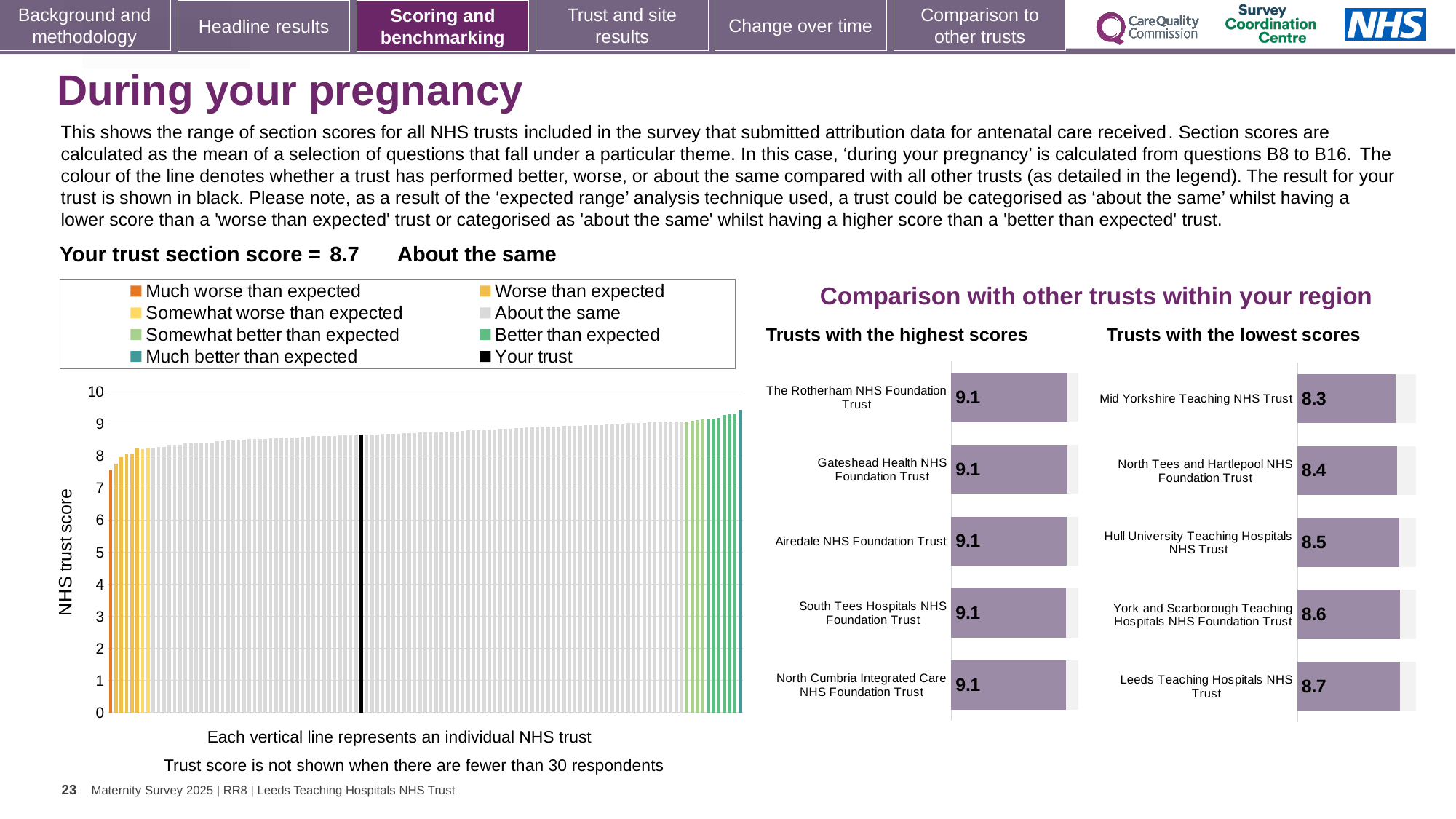
How many trusts are shown in the 'Trusts with the highest scores' chart? 5 In the 'Trusts with the lowest scores' chart, which trust has the highest score? Leeds Teaching Hospitals NHS Trust In the 'Trusts with the lowest scores' chart, what is the score for Mid Yorkshire Teaching NHS Trust? 8.3 In the 'Trusts with the lowest scores' chart, which trust has the lowest score? Mid Yorkshire Teaching NHS Trust In the main 'NHS trust score' chart, is the value of the black 'Your trust' bar greater or less than 8? greater In the 'Trusts with the lowest scores' chart, what is the difference between the scores of Leeds Teaching Hospitals NHS Trust and Mid Yorkshire Teaching NHS Trust? 0.4 In the main 'NHS trust score' chart, do the bar values rise or fall from left to right? Rise In the 'Trusts with the highest scores' chart, what is the score for Airedale NHS Foundation Trust? 9.1 How many entries does the legend of the main 'NHS trust score' chart list? 8 In the 'Trusts with the lowest scores' chart, what is the score for Hull University Teaching Hospitals NHS Trust? 8.5 In the 'Trusts with the lowest scores' chart, which has the larger score: Hull University Teaching Hospitals NHS Trust or North Tees and Hartlepool NHS Foundation Trust? Hull University Teaching Hospitals NHS Trust What kind of chart is the main 'NHS trust score' chart on the left? Bar chart